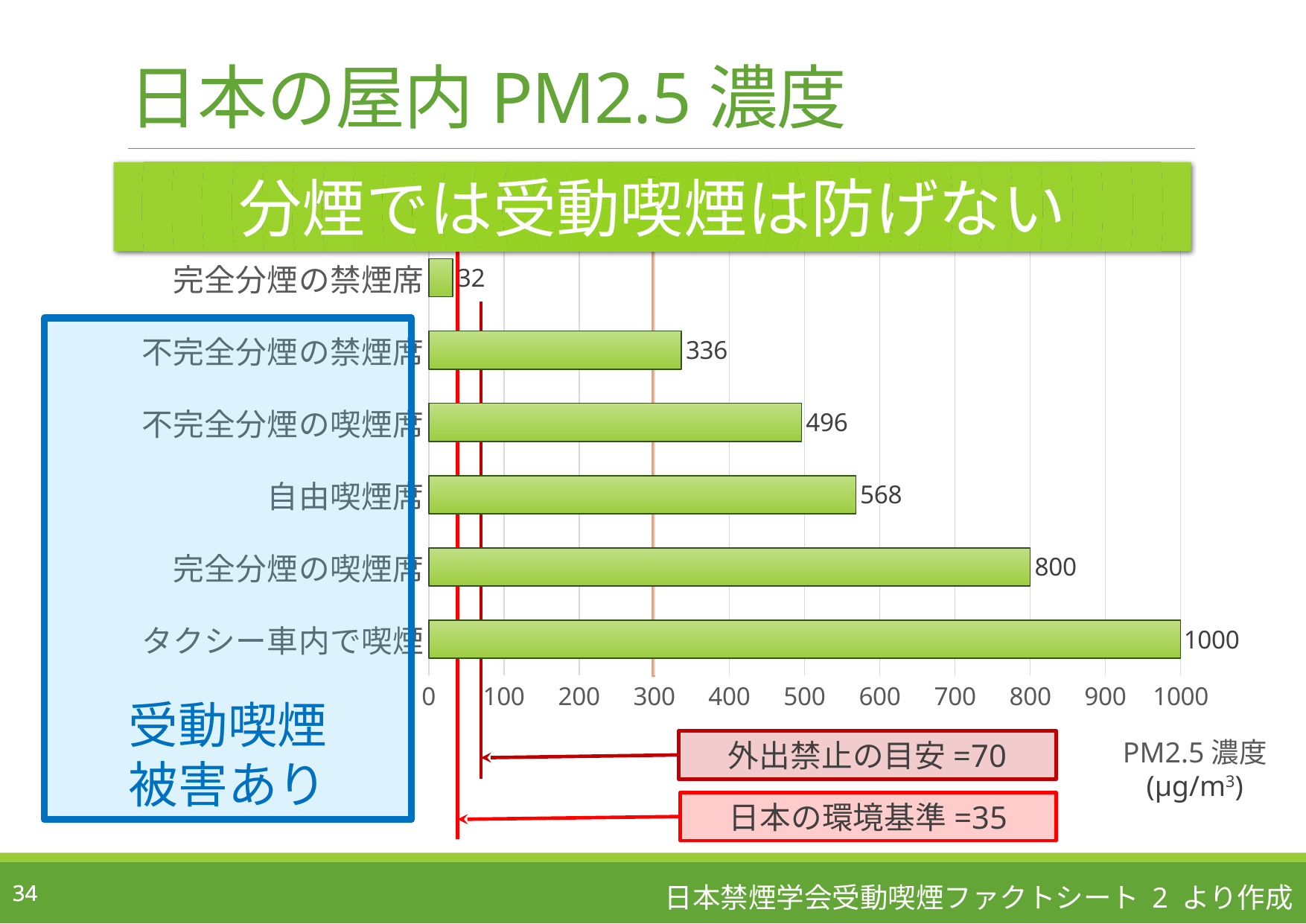
What is the value shown for 不完全分煙の禁煙席? 336 What is the difference between the values for タクシー車内で喫煙 and 完全分煙の喫煙席? 200 What is the PM2.5 concentration value for 完全分煙の禁煙席? 32 What is the value shown for 自由喫煙席? 568 Which category has the highest PM2.5 concentration? タクシー車内で喫煙 How many categories are plotted in the chart? 6 What kind of chart is shown on the slide? bar chart Which is larger, the value for 不完全分煙の喫煙席 or the value for 自由喫煙席? 自由喫煙席 What is the value shown for 完全分煙の喫煙席? 800 What value does the red line labelled 日本の環境基準 mark on the axis? 35 Is the value for 不完全分煙の喫煙席 greater or less than 400? greater Which category has the lowest PM2.5 concentration? 完全分煙の禁煙席